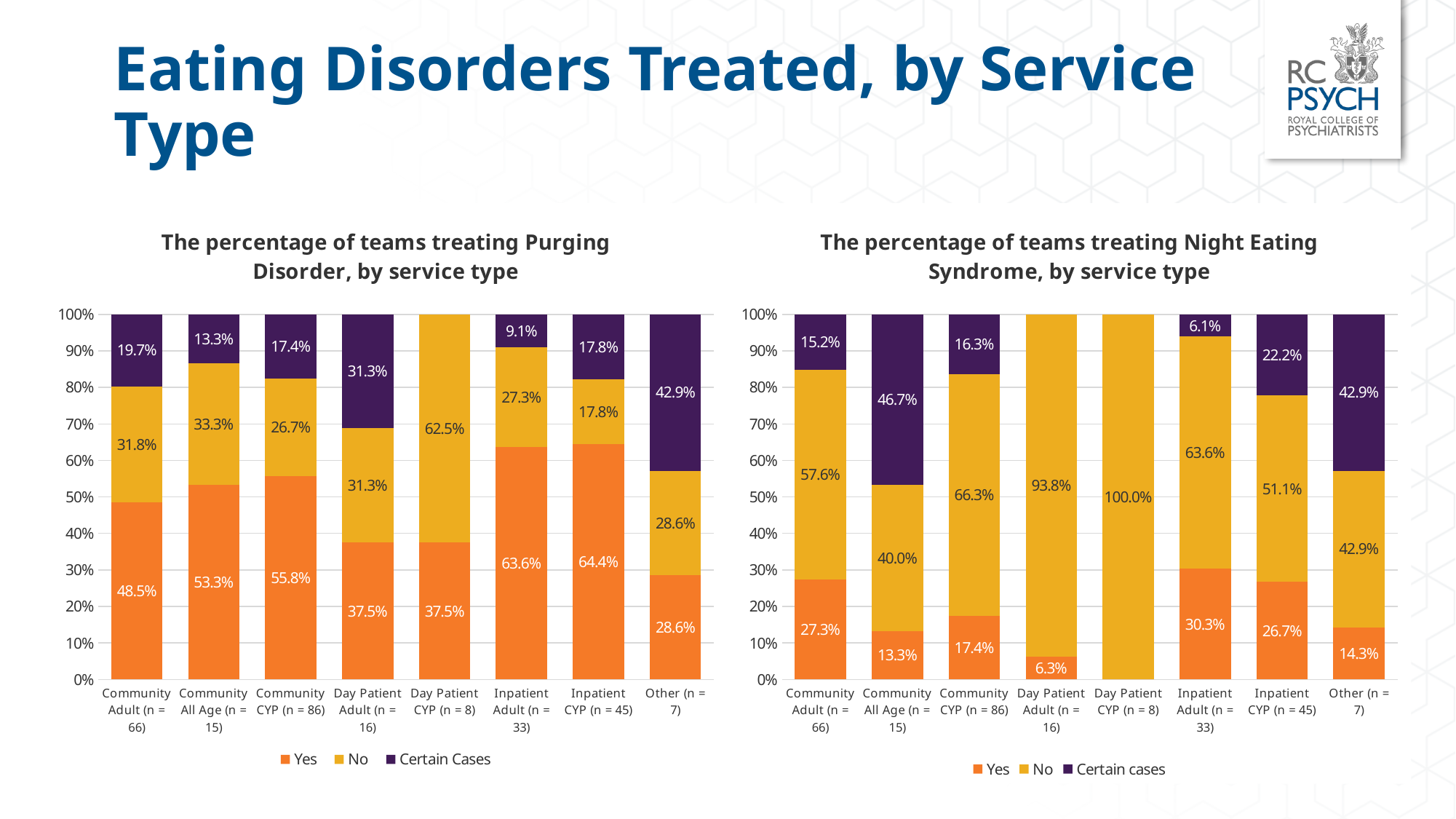
In the Purging Disorder chart, what is the difference between the Yes values for Inpatient Adult and Day Patient Adult? 26.1% In the Purging Disorder chart, what percentage of Community Adult teams answered Yes? 48.5% In the Night Eating Syndrome chart, which service type has the lowest Yes percentage among those with a Yes segment? Day Patient Adult (n = 16) How many series does the legend of the Night Eating Syndrome chart list? 3 In the Purging Disorder chart, which service type has the highest Yes percentage? Inpatient CYP (n = 45) What type of chart is the Purging Disorder chart? Stacked bar chart In the Night Eating Syndrome chart, which is larger: the Certain cases value for Community All Age or for Inpatient CYP? Community All Age Which colour represents the No series in both charts? Yellow How many service types are shown on the x axis of the Purging Disorder chart? 8 In the Purging Disorder chart, what is the Certain Cases value for Inpatient Adult (n = 33)? 9.1% In the Night Eating Syndrome chart, what is the No value for Day Patient Adult (n = 16)? 93.8% In the Night Eating Syndrome chart, what is the Certain cases value for Other (n = 7)? 42.9%